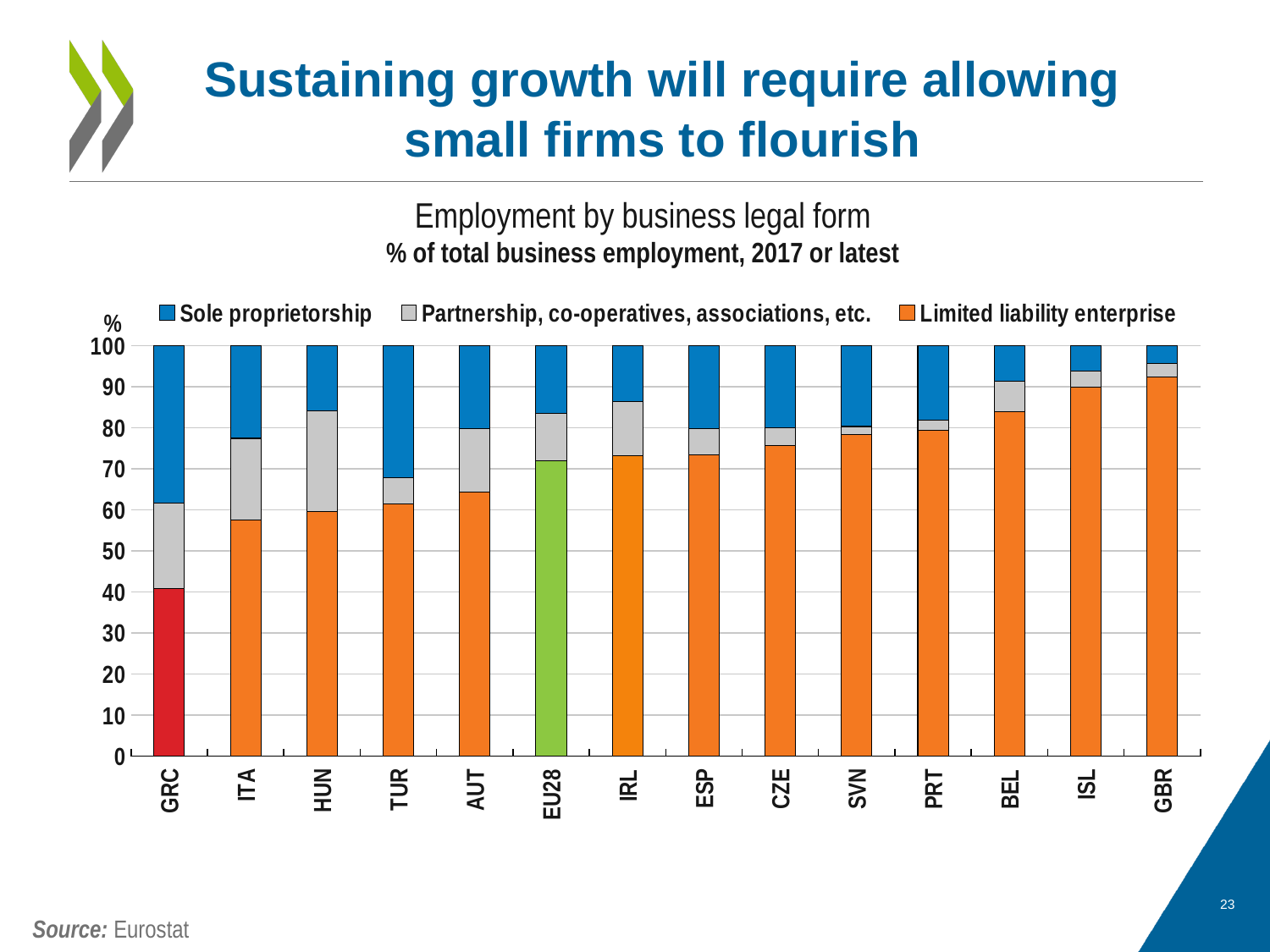
Which category has the largest sole proprietorship segment? GRC Which category has the highest share of employment in limited liability enterprises? GBR Does the limited liability enterprise share generally rise or fall moving from GRC on the left to GBR on the right? rise Is the limited liability enterprise share for GRC greater or less than 50? less How many countries or regions are shown on the x axis of the chart? 14 How many series does the legend list? 3 Which category has the lowest share of employment in limited liability enterprises? GRC Which has a larger limited liability enterprise share, AUT or IRL? IRL What is the total height of each stacked bar in the chart? 100 Is the limited liability enterprise share for EU28 greater or less than 60? greater Is the limited liability enterprise share for GBR greater or less than 80? greater What kind of chart is shown on the slide? Stacked bar chart